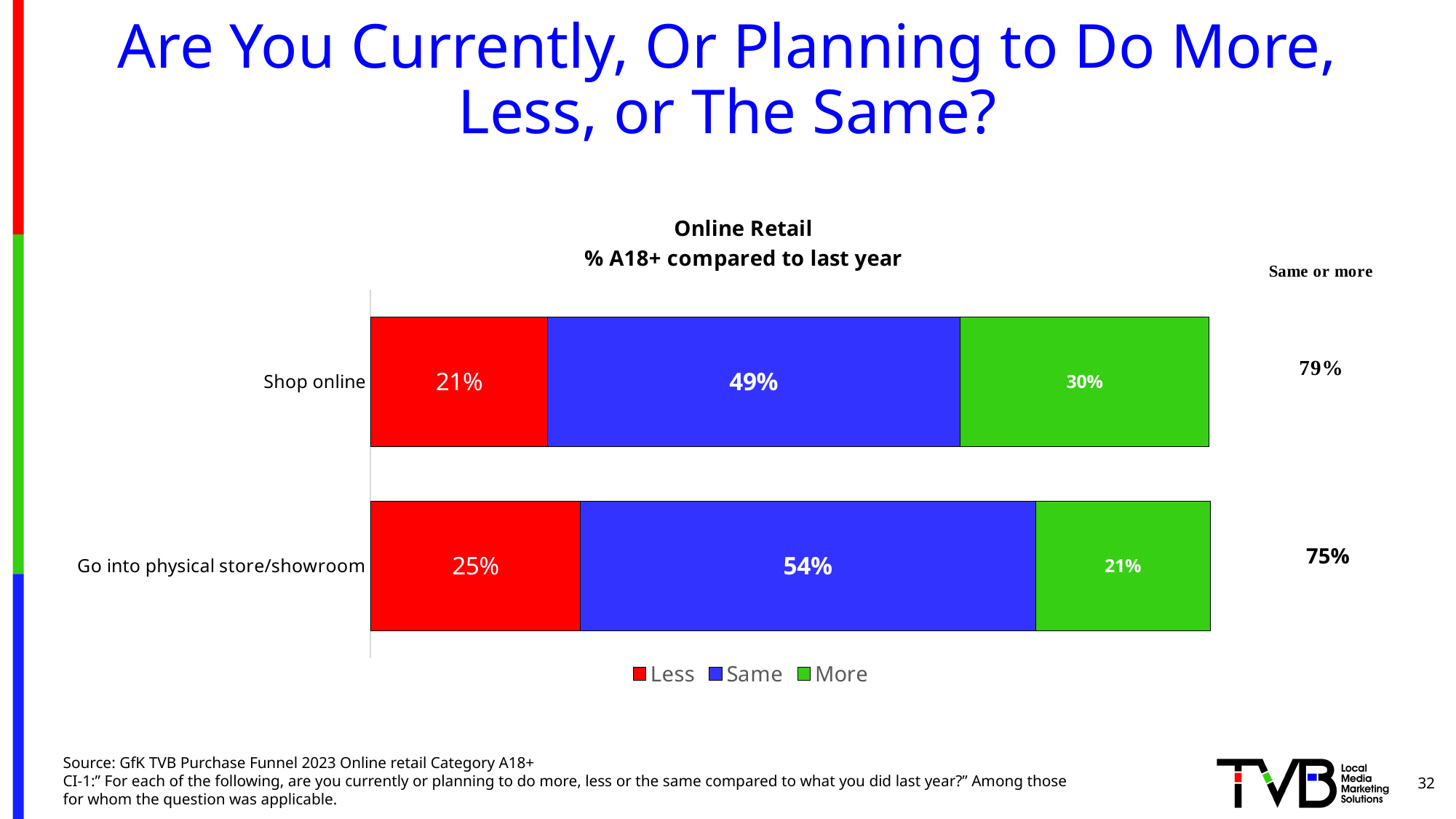
What percentage of respondents say they will shop online the same as last year? 49% How many categories are shown on the chart? 2 What is the difference between the 'Same or more' figures for Shop online and Go into physical store/showroom? 4% Which colour represents the 'Less' series in the chart? Red What percentage of respondents plan to go into a physical store/showroom less than last year? 25% Which category has the higher 'More' percentage, Shop online or Go into physical store/showroom? Shop online What percentage of respondents plan to shop online more than last year? 30% What is the total of the Less, Same and More segments for the Shop online bar? 100% What kind of chart is shown on the slide? Stacked bar chart How many series does the legend list? 3 What is the difference between the 'Same' percentages for Go into physical store/showroom and Shop online? 5% What is the 'Same or more' figure shown for Go into physical store/showroom? 75%